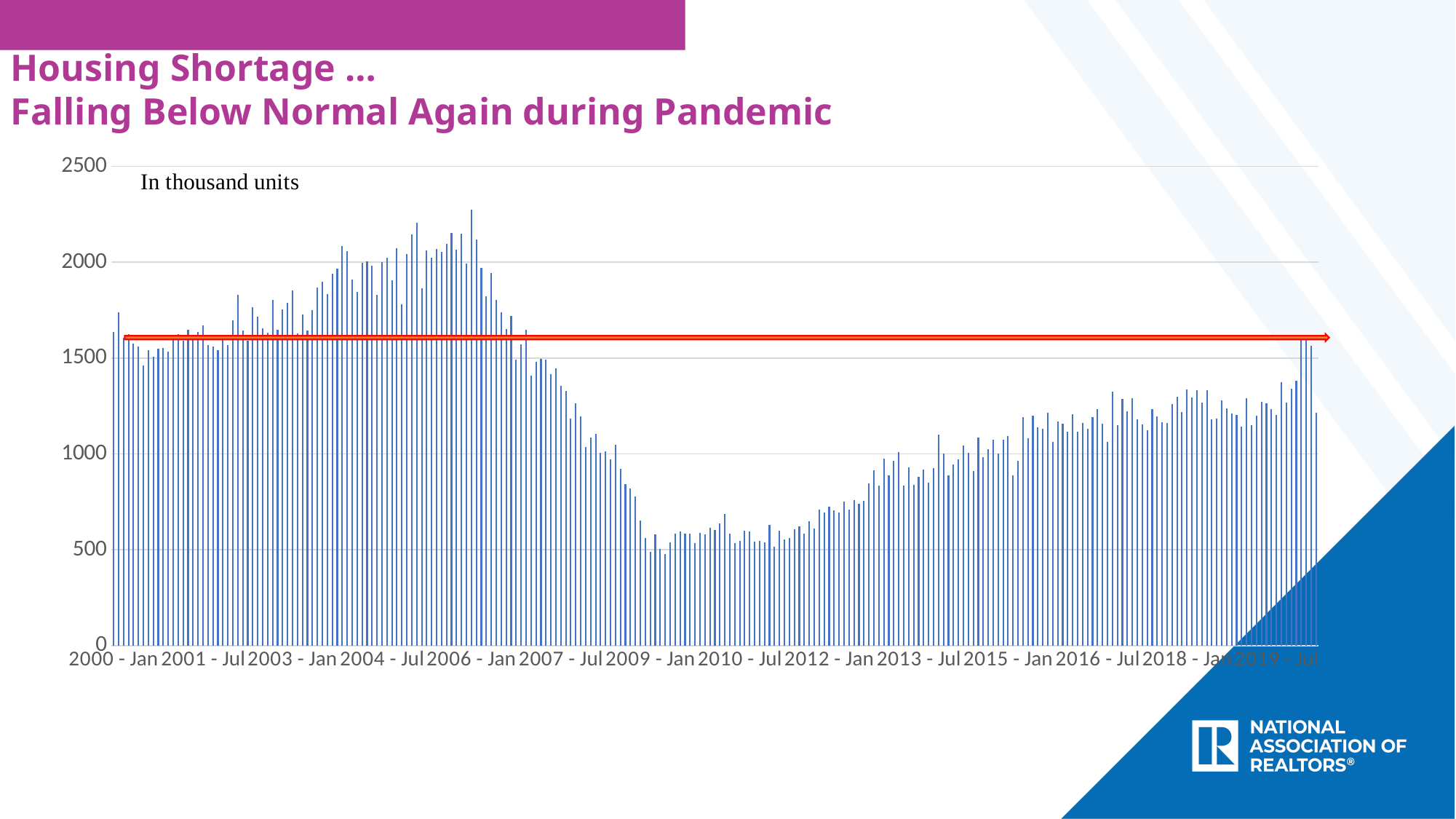
In what units are the values on the chart expressed, according to the note on the chart? In thousand units Is the value for 2009 - Jan greater or less than 1000? less Is the value for 2007 - Jul greater or less than 1500? less What kind of chart is shown on the slide? bar chart Do the values rise or fall between 2006 - Jan and 2009 - Jan? fall What is the title of the slide's chart? Housing Shortage ... Falling Below Normal Again during Pandemic Is the value for 2006 - Jan greater or less than 2000? greater Do the values generally rise or fall between 2009 - Jan and 2019 - Jul? rise In which year does the chart reach its highest value? 2006